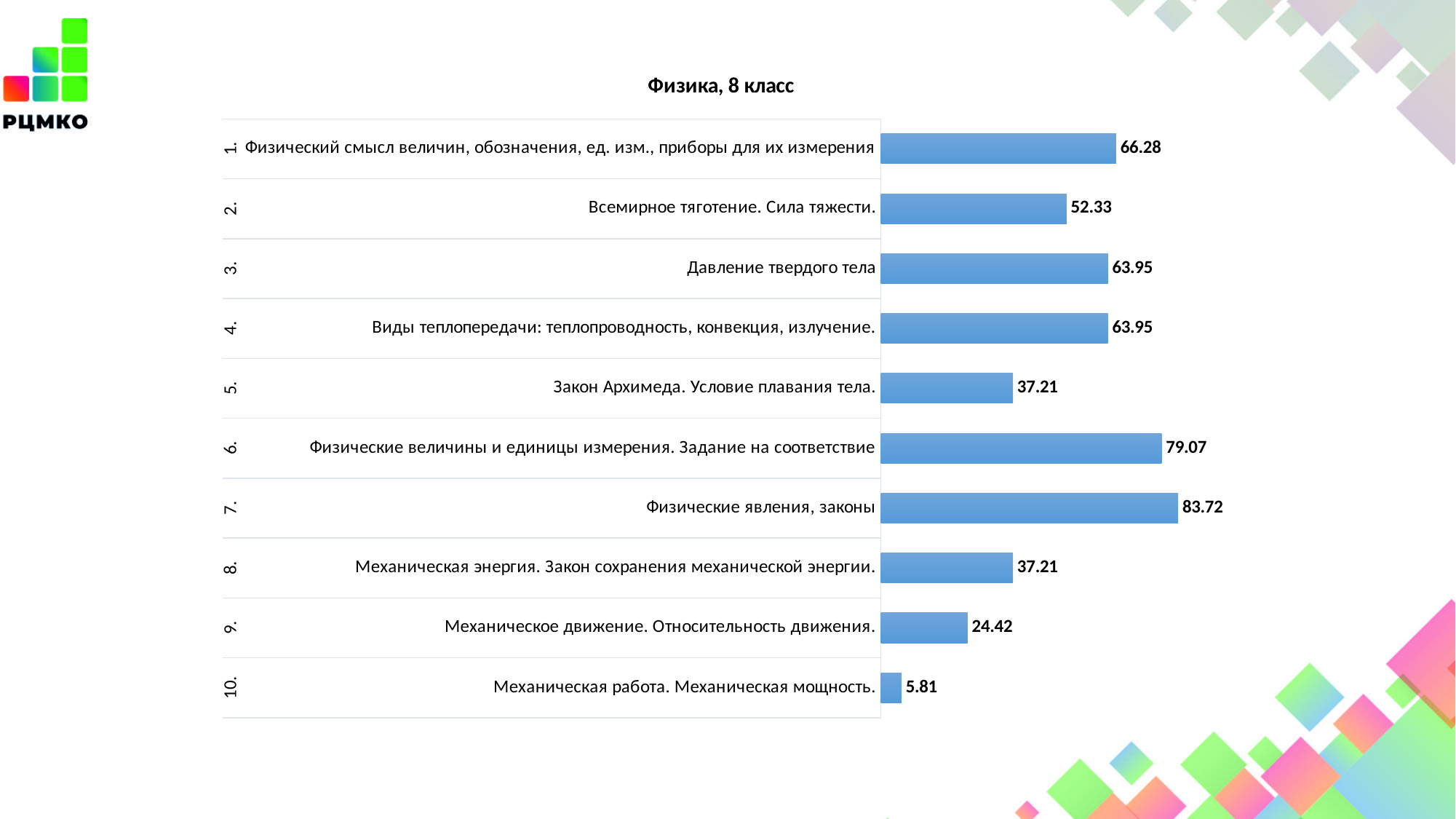
Which category has the highest value? Физические явления, законы What kind of chart is shown on the slide? Bar chart What is the value for "Физические явления, законы"? 83.72 What is the value for "Всемирное тяготение. Сила тяжести."? 52.33 What is the value for "Закон Архимеда. Условие плавания тела."? 37.21 Which is larger: the value for "Физические величины и единицы измерения. Задание на соответствие" or the value for "Давление твердого тела"? Физические величины и единицы измерения. Задание на соответствие Which category has the lowest value? Механическая работа. Механическая мощность. What is the value for "Механическая работа. Механическая мощность."? 5.81 What is the difference between the value for "Физический смысл величин, обозначения, ед. изм., приборы для их измерения" and the value for "Всемирное тяготение. Сила тяжести."? 13.95 What is the difference between the highest value (83.72) and the lowest value (5.81)? 77.91 How many categories are shown in the chart? 10 What is the title of the chart? Физика, 8 класс